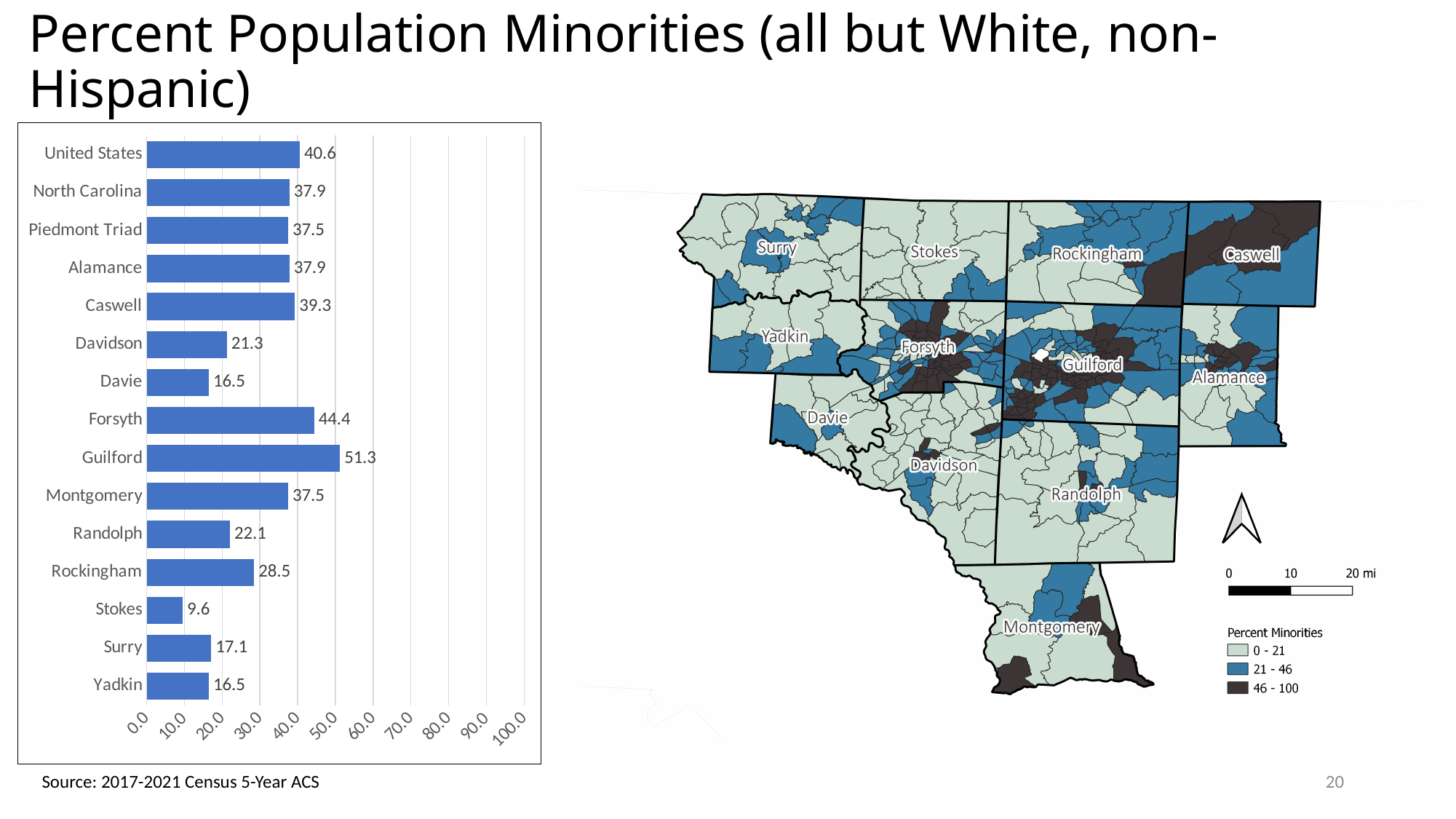
What kind of chart is shown on the left of the slide? Bar chart How many categories are shown in the bar chart? 15 What is the highest value shown on the x axis of the bar chart? 100.0 What is the value for the United States in the bar chart? 40.6 Which category has the highest value in the bar chart? Guilford Which has a larger value in the bar chart, Rockingham or Randolph? Rockingham What is the value for Stokes in the bar chart? 9.6 What is the difference between the values for Guilford and Forsyth in the bar chart? 6.9 Is the value for Forsyth in the bar chart greater or less than 40.0? greater What is the value for Guilford in the bar chart? 51.3 What is the difference between the values for North Carolina and Davidson in the bar chart? 16.6 Which category has the lowest value in the bar chart? Stokes